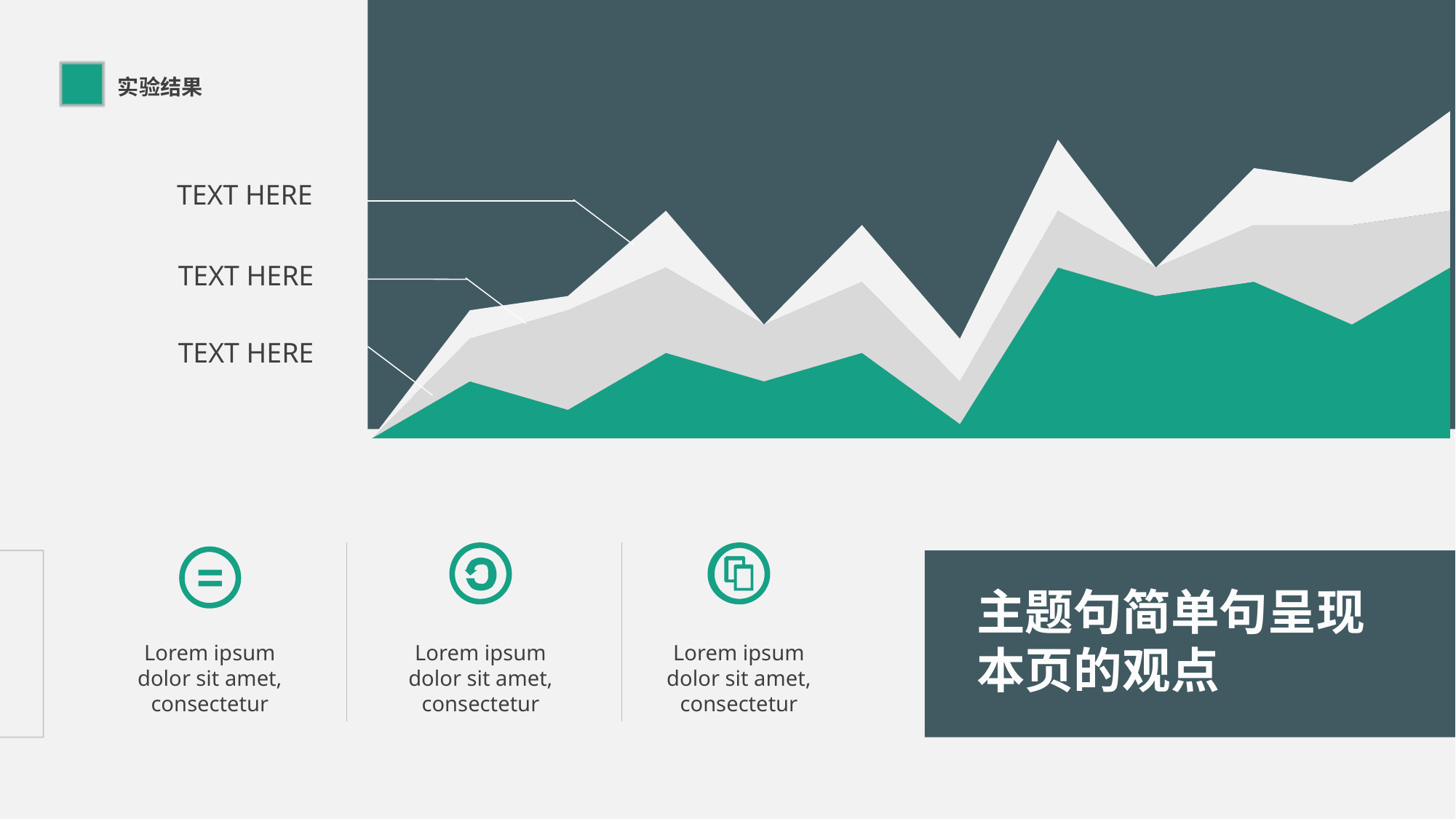
How many stacked series (layers) are plotted in the area chart? 3 What is the section label shown at the top left of the slide above the chart? 实验结果 Do the values in the area chart generally rise or fall from left to right? rise Does the bottom (green) series of the area chart generally rise or fall from left to right? rise What kind of chart is shown on the slide? area chart What colour is the bottom layer of the area chart? green